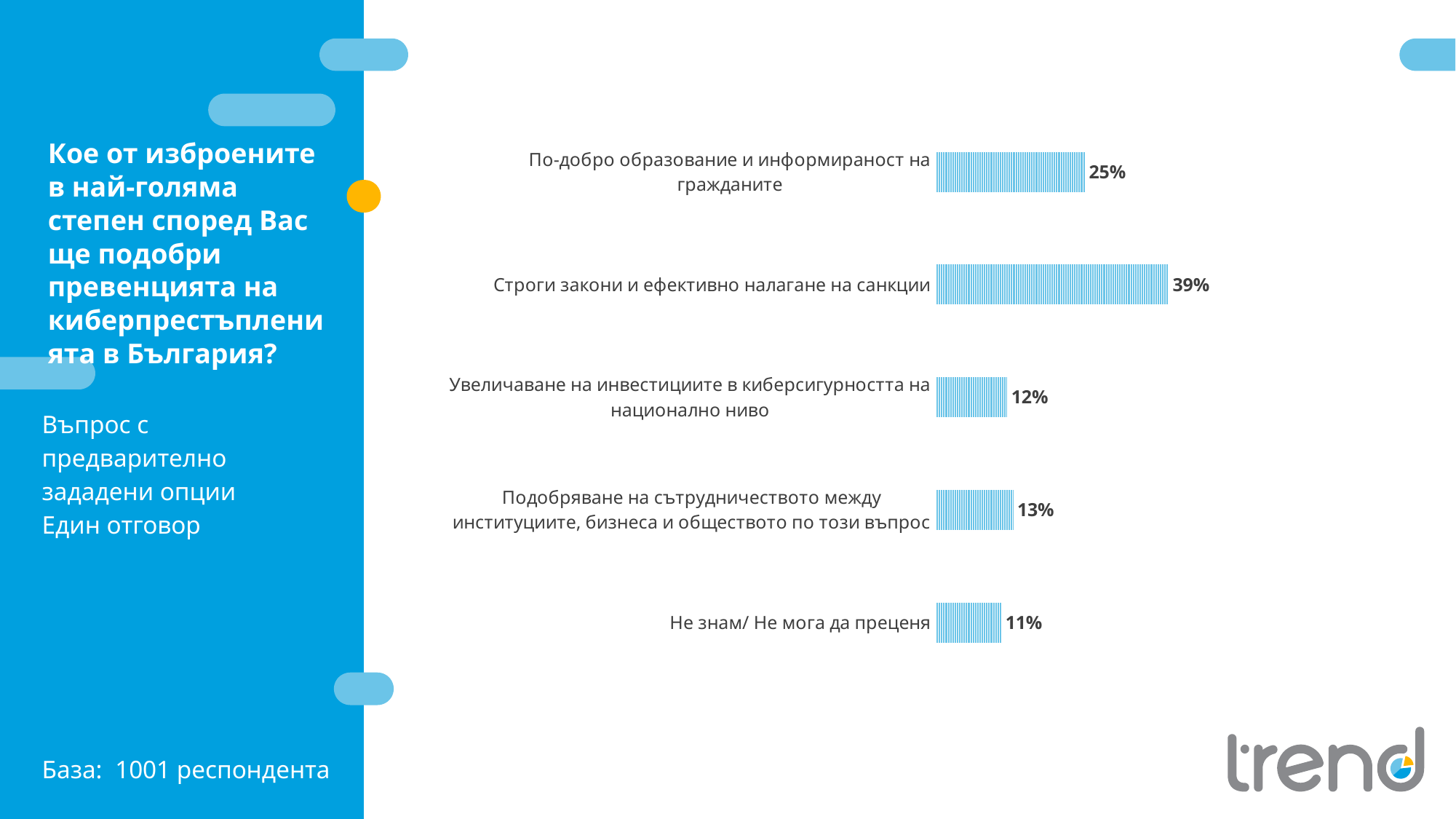
Which category has the lowest value? Не знам/ Не мога да преценя What is the value for "Увеличаване на инвестициите в киберсигурността на национално ниво"? 12% What kind of chart is shown on the slide? Bar chart How many respondents form the base of the survey shown on the slide? 1001 What is the value for "Строги закони и ефективно налагане на санкции"? 39% How many categories are shown in the chart? 5 What is the difference between the values for "Строги закони и ефективно налагане на санкции" and "По-добро образование и информираност на гражданите"? 14% Which is larger: the value for "Подобряване на сътрудничеството между институциите, бизнеса и обществото по този въпрос" or the value for "Увеличаване на инвестициите в киберсигурността на национално ниво"? Подобряване на сътрудничеството между институциите, бизнеса и обществото по този въпрос What is the value for "Не знам/ Не мога да преценя"? 11% Which category has the highest value? Строги закони и ефективно налагане на санкции What is the difference between the values for "Подобряване на сътрудничеството между институциите, бизнеса и обществото по този въпрос" and "Не знам/ Не мога да преценя"? 2% What is the value for "По-добро образование и информираност на гражданите"? 25%